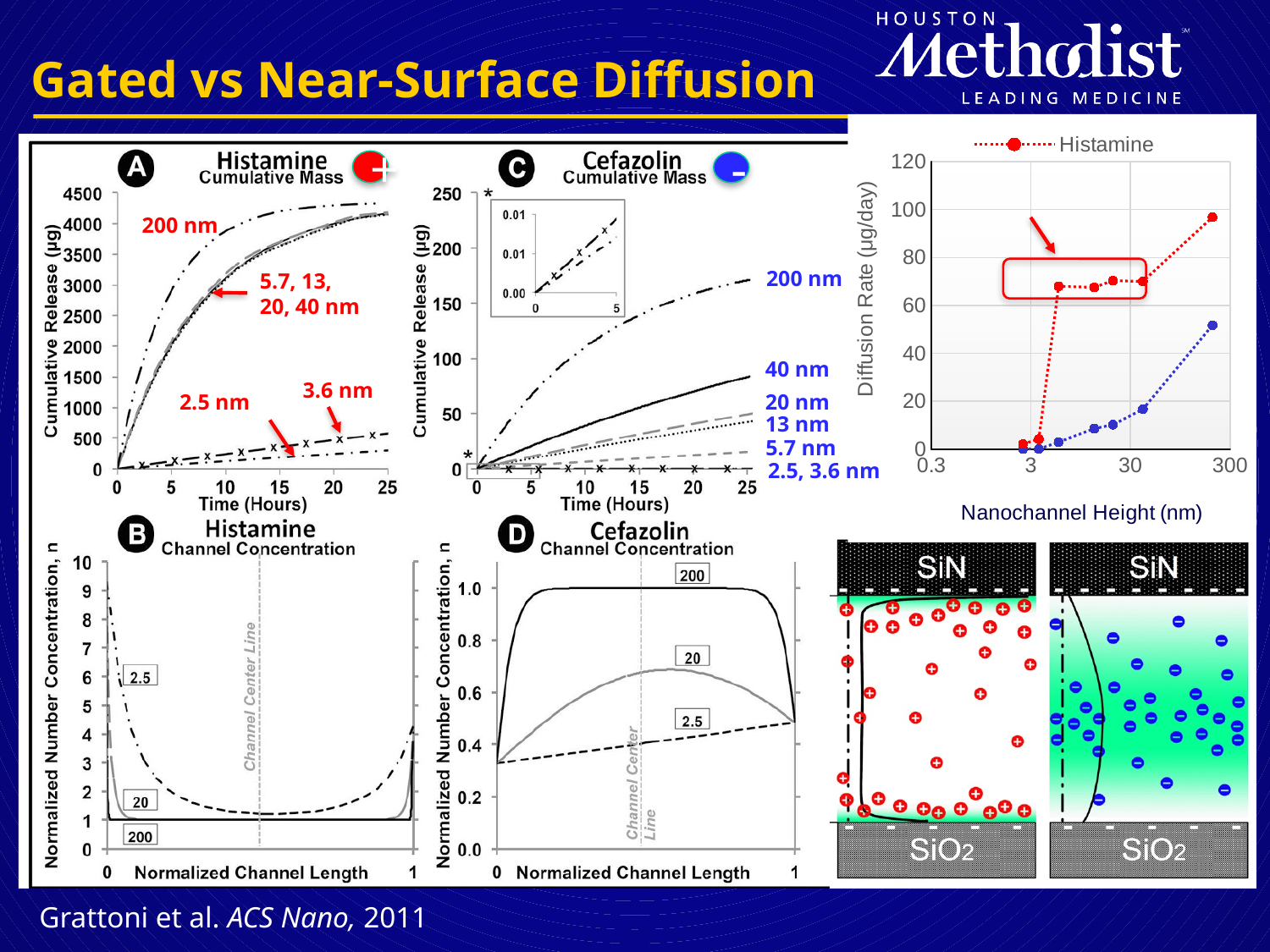
In the top-right Diffusion Rate chart, is the blue series value at the largest nanochannel height greater or less than 60 µg/day? less What kind of chart is the top-right chart of Diffusion Rate versus Nanochannel Height? line chart In the top-right Diffusion Rate chart, which series does the legend name? Histamine In chart D (Cefazolin Channel Concentration), which curve is higher at the channel center line, the 200 curve or the 2.5 curve? 200 In chart A (Histamine Cumulative Mass), is the cumulative release for the 200 nm channel at 25 hours greater or less than 4000 µg? greater In the top-right Diffusion Rate chart, what is the y-axis label? Diffusion Rate (µg/day) In chart C (Cefazolin Cumulative Mass), which nanochannel height gives the highest cumulative release? 200 nm In the top-right Diffusion Rate chart, is the Histamine diffusion rate at the largest nanochannel height greater or less than 80 µg/day? greater In chart B (Histamine Channel Concentration), how many channel-height curves are plotted? 3 In the top-right Diffusion Rate chart, does the Histamine diffusion rate rise or fall as nanochannel height increases? rise In chart A (Histamine Cumulative Mass), which nanochannel height gives the highest cumulative release? 200 nm